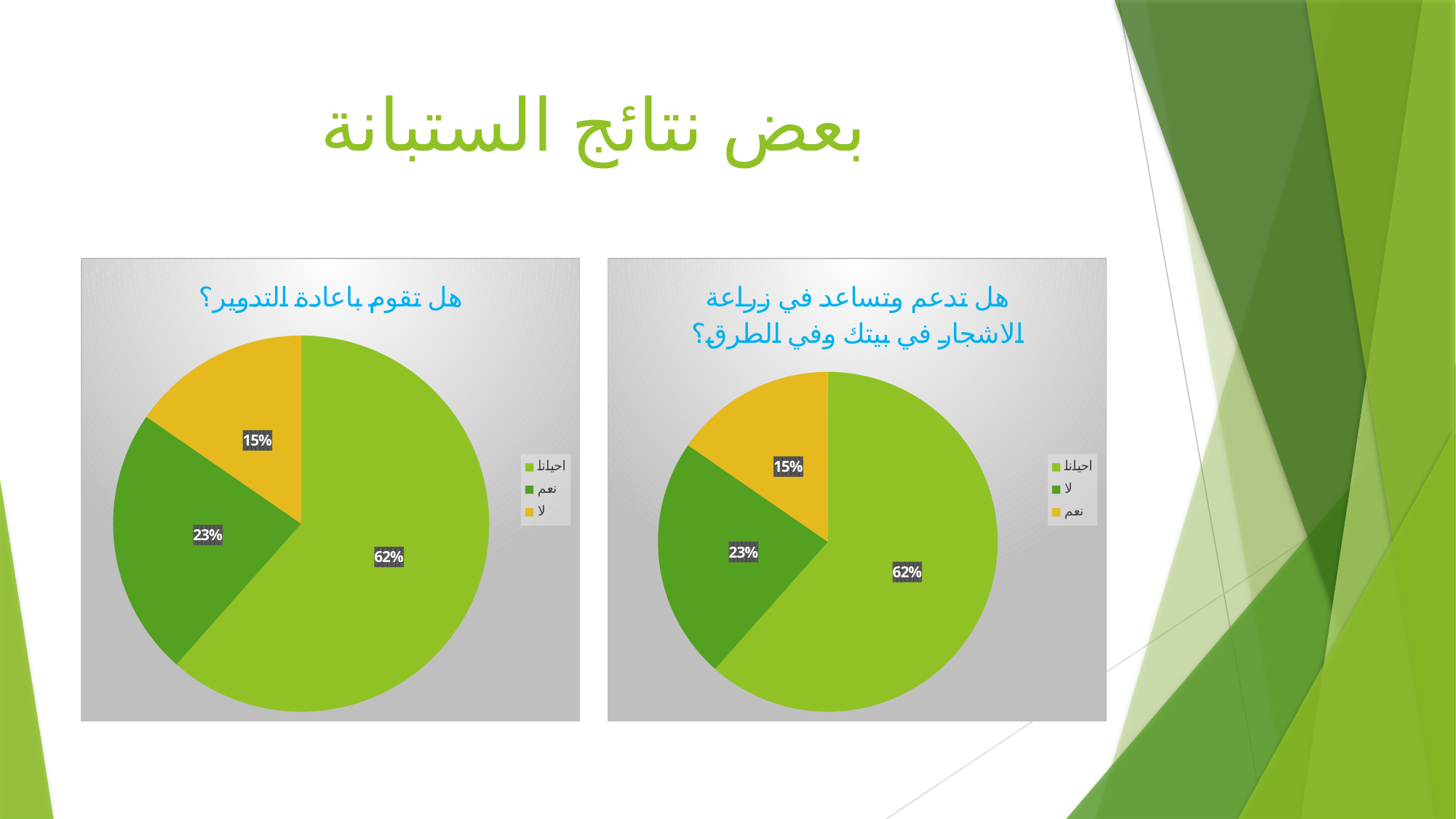
In the right pie chart (هل تدعم وتساعد في زراعة الاشجار في بيتك وفي الطرق؟), what percentage is shown for نعم? 15% In the right pie chart (هل تدعم وتساعد في زراعة الاشجار في بيتك وفي الطرق؟), what percentage is shown for لا? 23% How many slices does the left pie chart have? 3 In the left pie chart, what is the difference in percentage points between احيانا and نعم? 39 In the right pie chart, which category has the largest share? احيانا In the left pie chart (هل تقوم باعادة التدوير؟), what percentage is shown for نعم? 23% What type of chart is the right chart on the slide? Pie chart In the left pie chart (هل تقوم باعادة التدوير؟), what percentage is shown for احيانا? 62% In the right pie chart, which is larger: the share for لا or the share for نعم? لا In the left pie chart, which category has the smallest share? لا In the left pie chart (هل تقوم باعادة التدوير؟), what percentage is shown for لا? 15% In the right pie chart, which colour represents نعم in the legend? Yellow